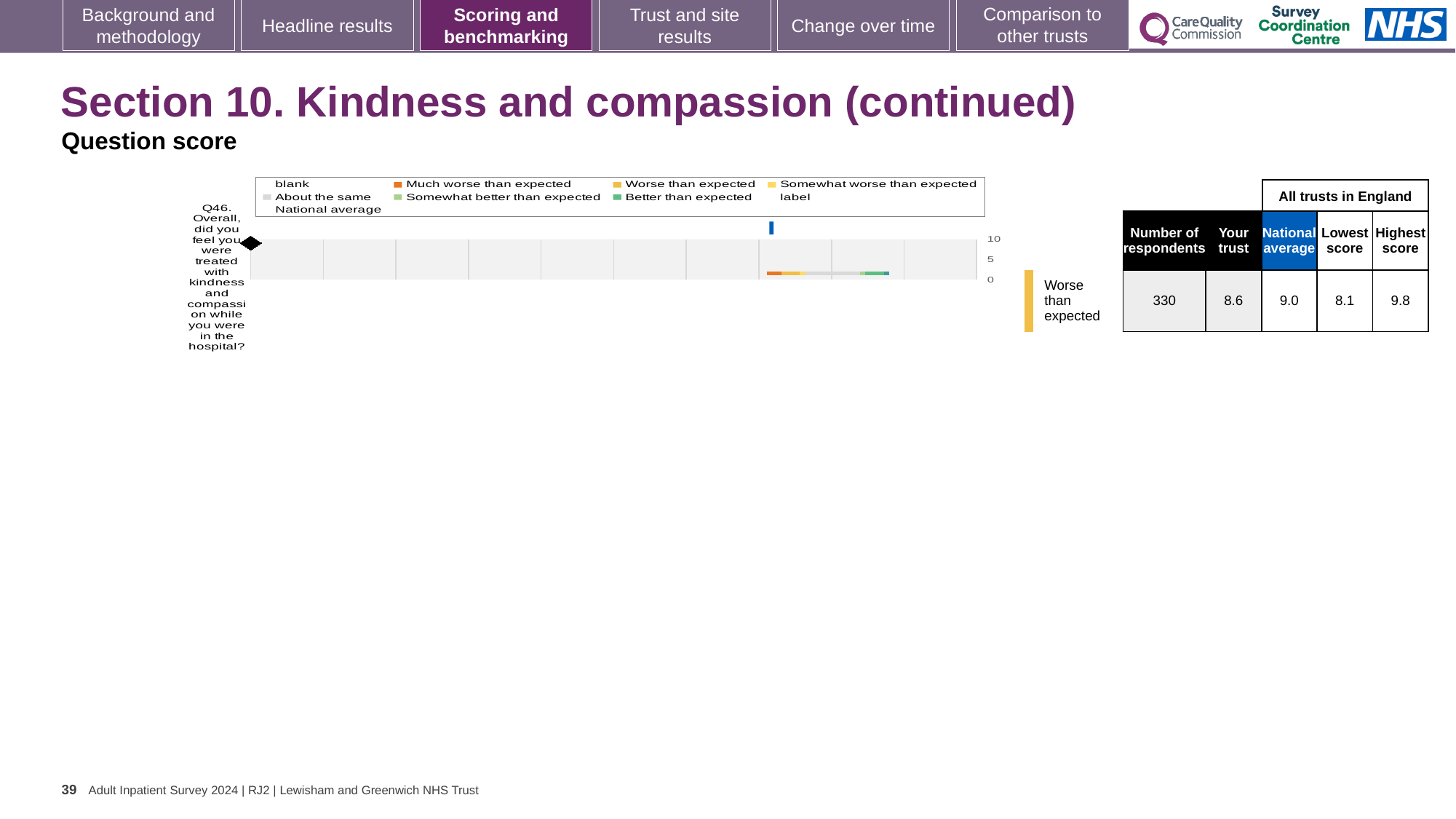
What is the difference between the national average and the 'Your trust' score for Q46? 0.4 Which is larger for Q46, the 'Your trust' score or the national average? National average What is the difference between the highest score and the lowest score for Q46? 1.7 How many respondents answered Q46? 330 What is the highest score among all trusts in England for Q46? 9.8 What kind of chart is shown on the slide? bar chart What is the 'Your trust' score for Q46? 8.6 What is the national average score for Q46? 9.0 What benchmark rating is shown next to the chart for Q46? Worse than expected Which question is plotted on the chart? Q46. Overall, did you feel you were treated with kindness and compassion while you were in the hospital? What is the lowest score among all trusts in England for Q46? 8.1 How many questions (categories) are plotted on the chart? 1